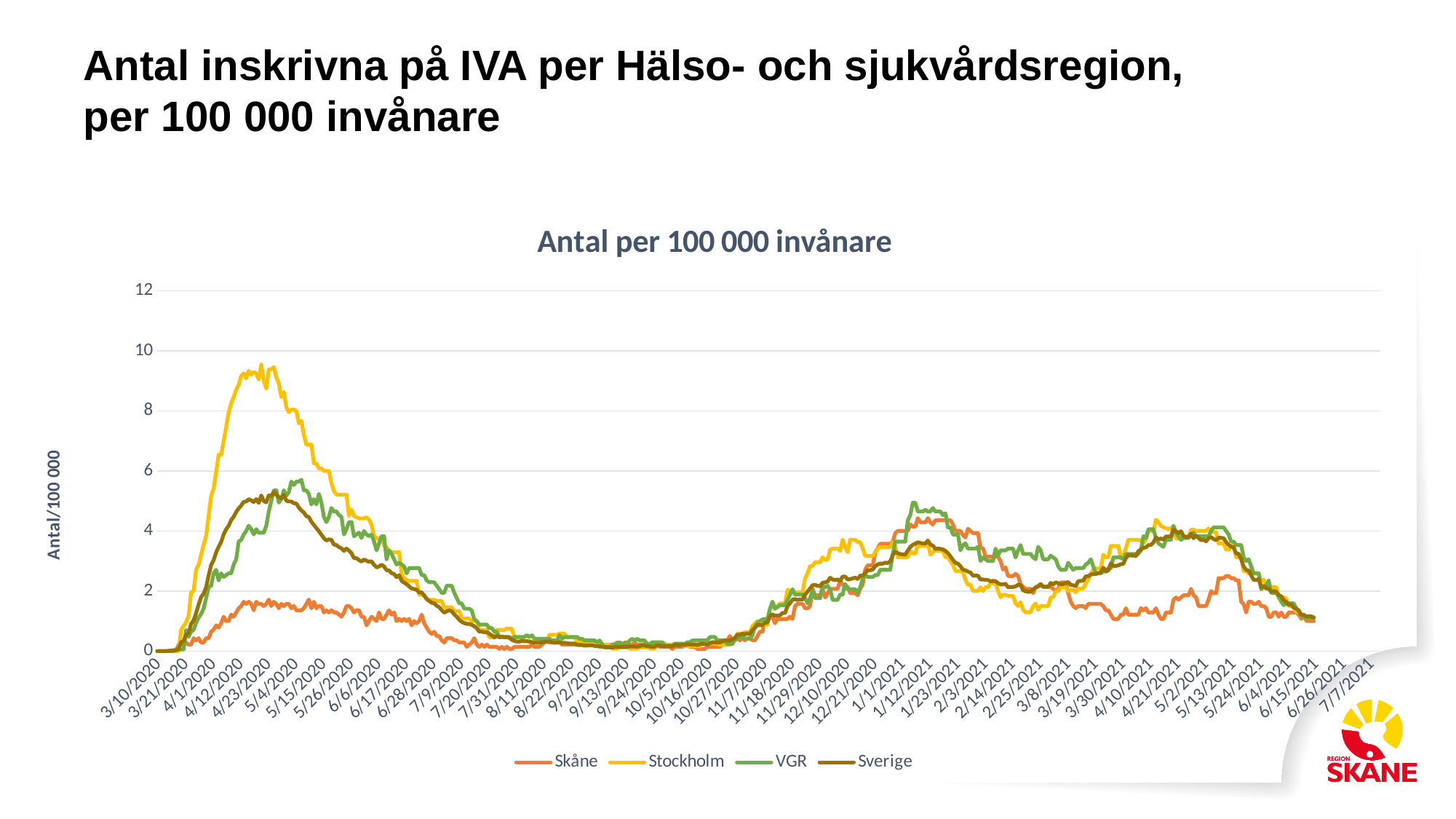
How many series does the legend list? 4 Which series reaches the highest peak in the chart? Stockholm Around 4/23/2020, which is larger: the value for Stockholm or the value for VGR? Stockholm Is the value for Sverige around 4/23/2020 greater or less than 4? greater What is the highest tick value shown on the y axis? 12 What kind of chart is shown on the slide? line chart Which series has the lowest values during April 2020? Skåne Is the peak value for Stockholm in spring 2020 greater or less than 8? greater Is the value for Skåne around 4/23/2020 greater or less than 2? less What is the title of the chart? Antal per 100 000 invånare Which series are listed in the legend? Skåne, Stockholm, VGR, Sverige Do the values for Stockholm rise or fall between 5/4/2020 and 7/31/2020? fall